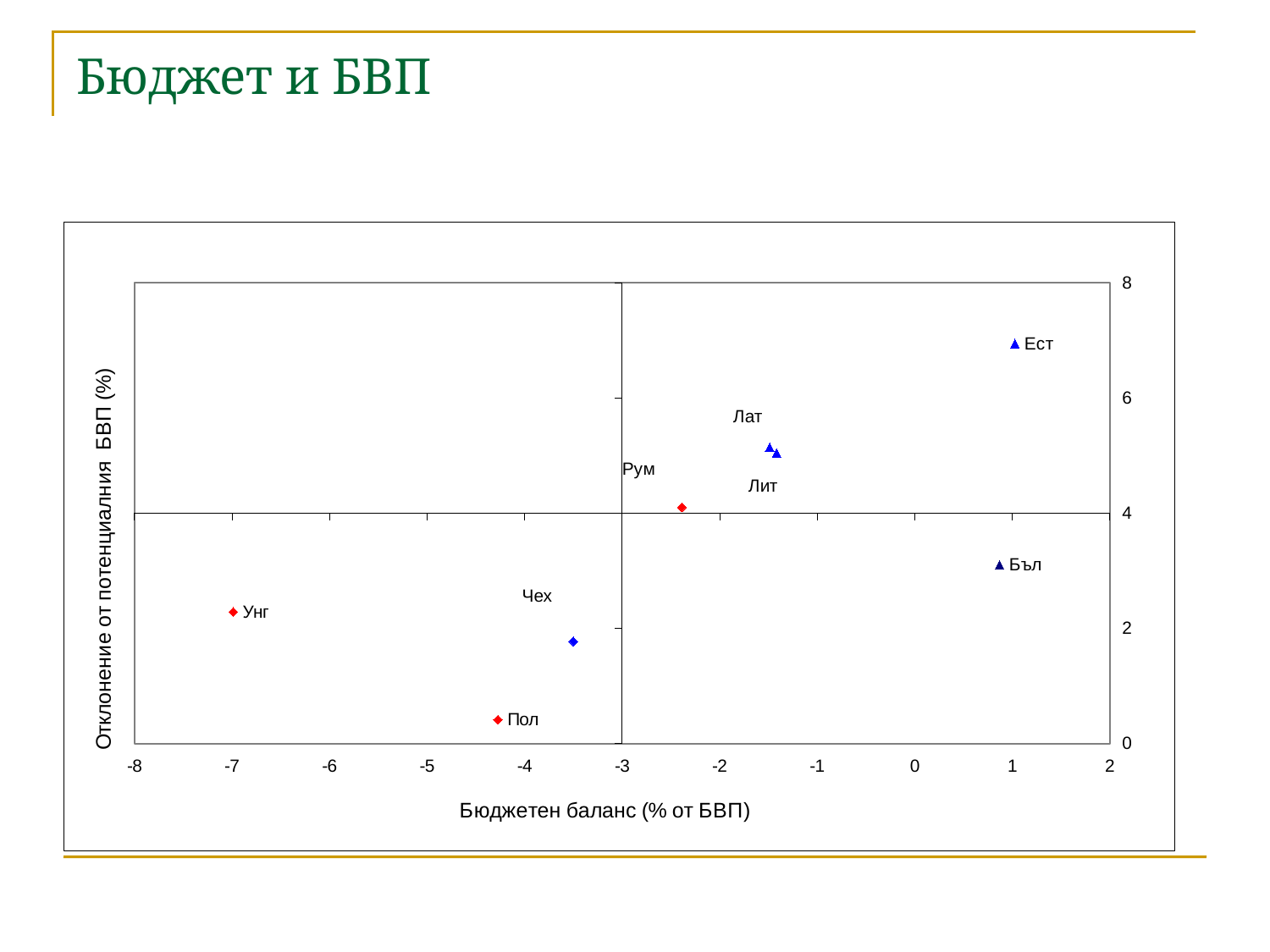
Is the deviation from potential GDP for Ест greater or less than 6? greater Which has a higher budget balance, Чех or Унг? Чех Is the budget balance for Бъл greater or less than 0? greater What is the title of the x axis? Бюджетен баланс (% от БВП) What kind of chart is shown on the slide? scatter chart How many labelled data points are plotted on the chart? 8 Which country has the highest deviation from potential GDP (highest point on the y axis)? Ест Which country has the lowest budget balance (furthest left on the x axis)? Унг Which country has the lowest deviation from potential GDP (lowest point on the y axis)? Пол Is the budget balance for Унг greater or less than -6? less Which has a higher deviation from potential GDP, Ест or Бъл? Ест